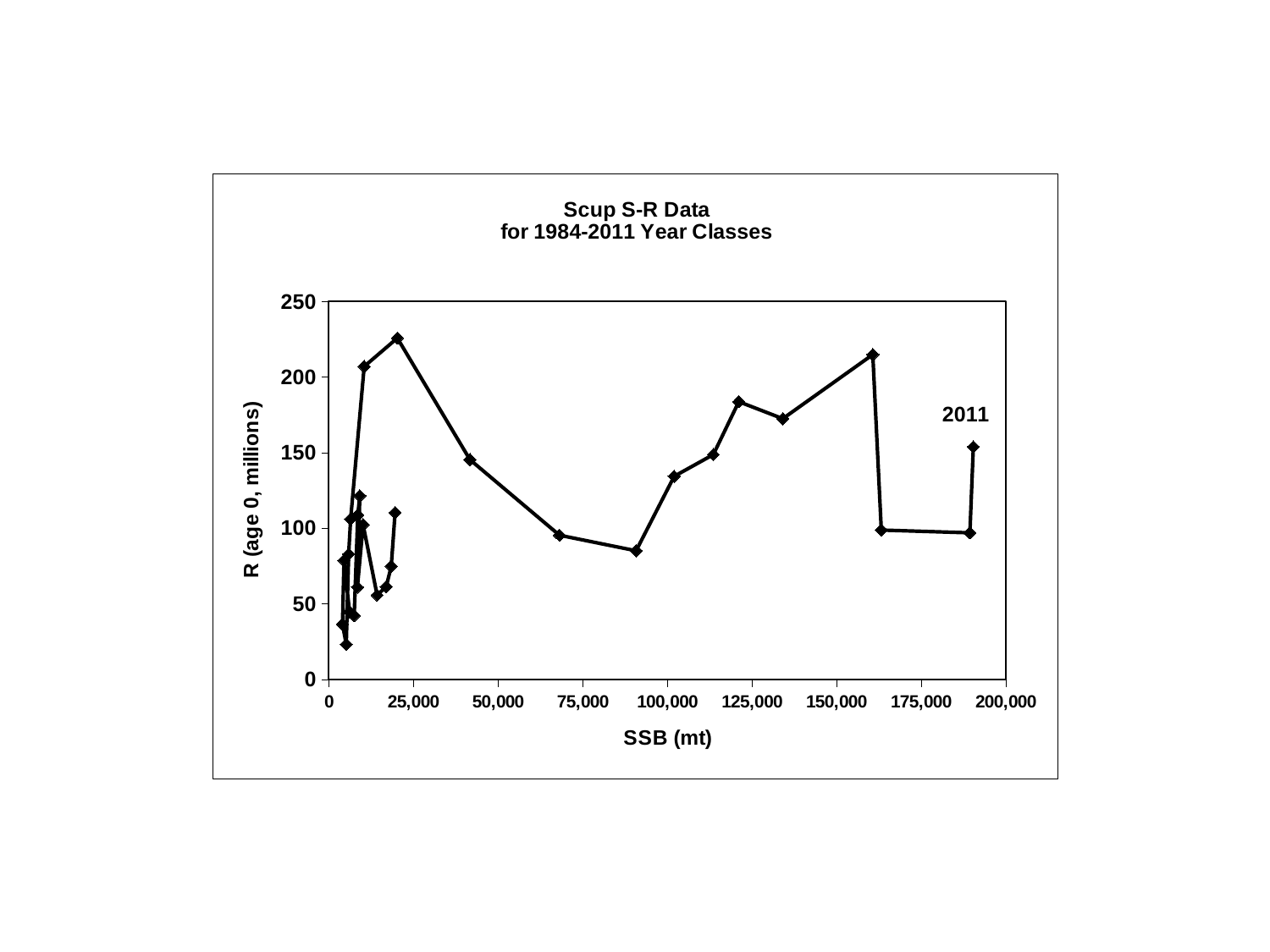
Is the R value for the point near SSB 90,000 greater or less than 100? less What is the title of the chart? Scup S-R Data for 1984-2011 Year Classes Is the lowest R value plotted on the chart greater or less than 50? less Which year class is labeled next to a data point on the chart? 2011 What is the maximum value shown on the y axis? 250 Is the R value for the point labeled 2011 greater or less than 100? greater What is the label of the x axis? SSB (mt) What kind of chart is shown on the slide? line chart